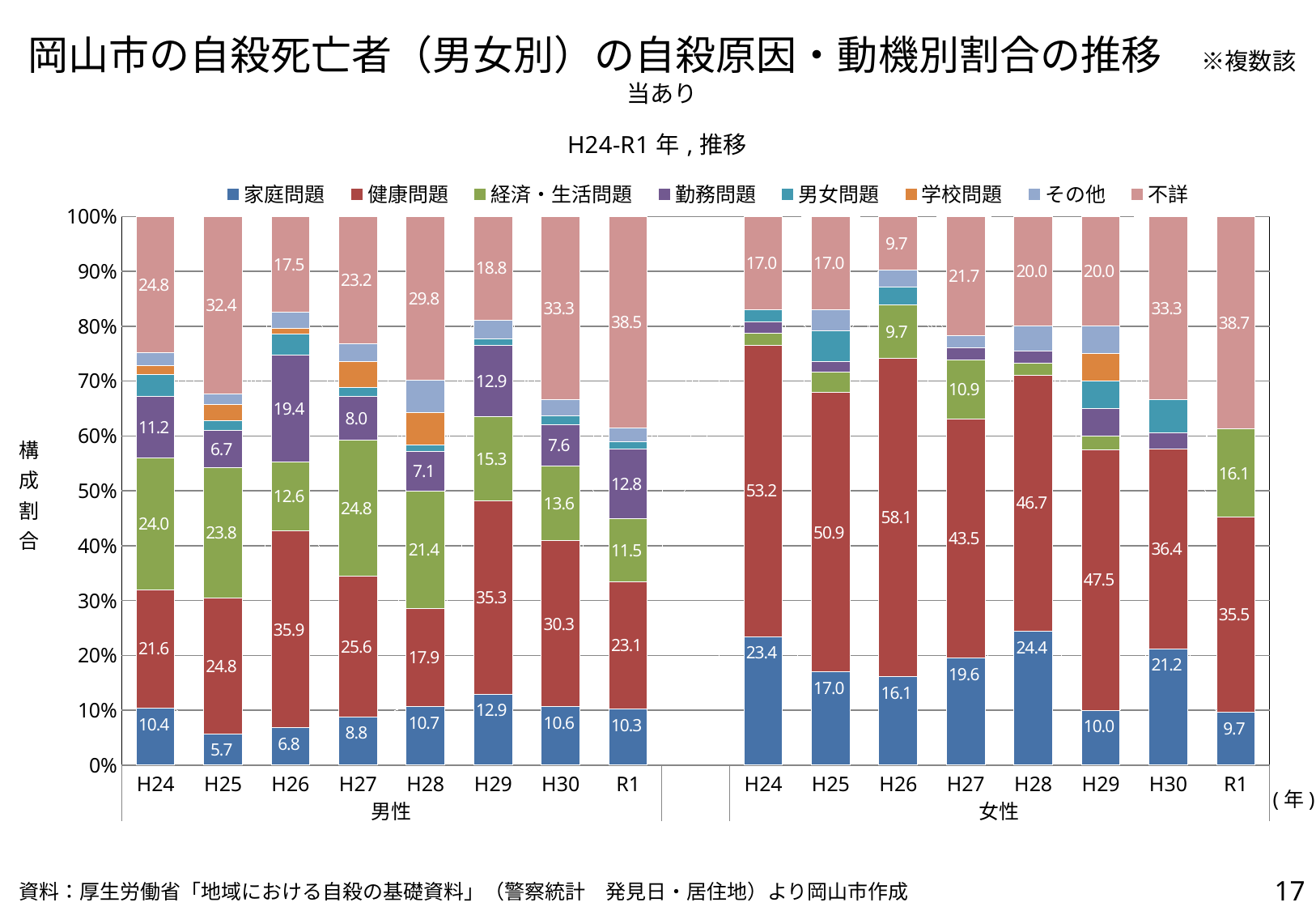
Among the 女性 bars, which year has the highest value for 健康問題? H26 What is the value of 健康問題 for 女性 in H26? 58.1 What is the value of 経済・生活問題 for 女性 in R1? 16.1 Which is larger: the 勤務問題 value for 男性 in H26 or in H27? H26 How many series does the legend list? 8 How many years are shown for each of the 男性 and 女性 groups? 8 What kind of chart is shown on the slide? Stacked bar chart Among the 男性 bars, which year has the highest value for 不詳? R1 What is the difference between the 健康問題 value for 女性 in H24 and for 男性 in H24? 31.6 Among the 男性 bars, which year has the lowest value for 家庭問題? H25 What is the value of 健康問題 for 男性 in H26? 35.9 Does the 健康問題 value for 女性 overall rise or fall from H24 to R1? Fall